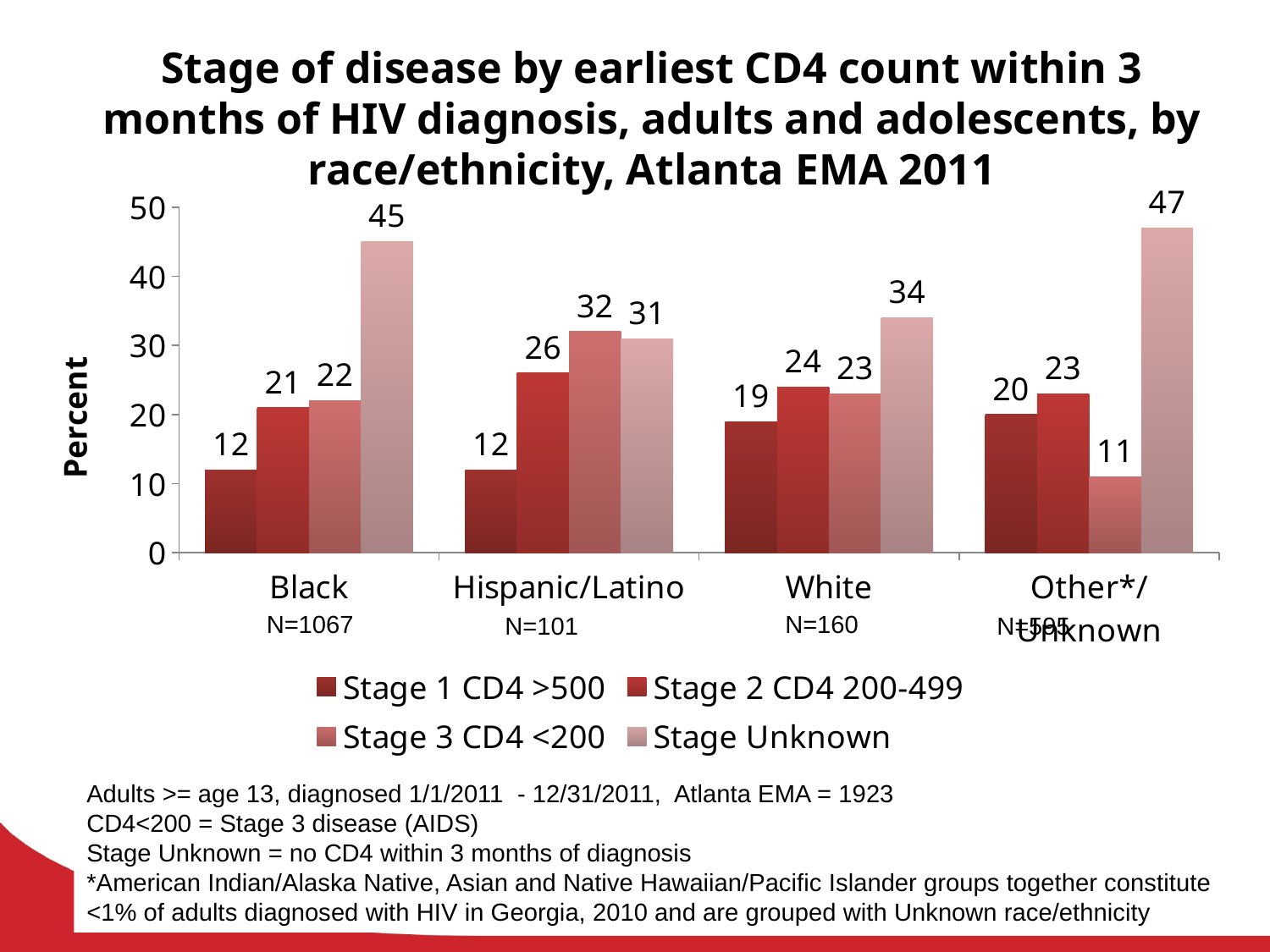
What is the difference between the Stage Unknown value and the Stage 1 CD4 >500 value for Black? 33 What is the Stage 2 CD4 200-499 value for Hispanic/Latino? 26 What is the Stage Unknown value for Black? 45 Which race/ethnicity group has the highest Stage Unknown value? Other*/Unknown What is the label of the y axis? Percent What is the Stage 3 CD4 <200 value for Other*/Unknown? 11 Which race/ethnicity group has the lowest Stage 3 CD4 <200 value? Other*/Unknown What kind of chart is shown on the slide? bar chart How many series does the legend list? 4 Is the Stage Unknown value for White greater or less than 30? greater How many race/ethnicity categories are shown on the x axis? 4 Is the Stage 1 CD4 >500 value larger for White or for Black? White